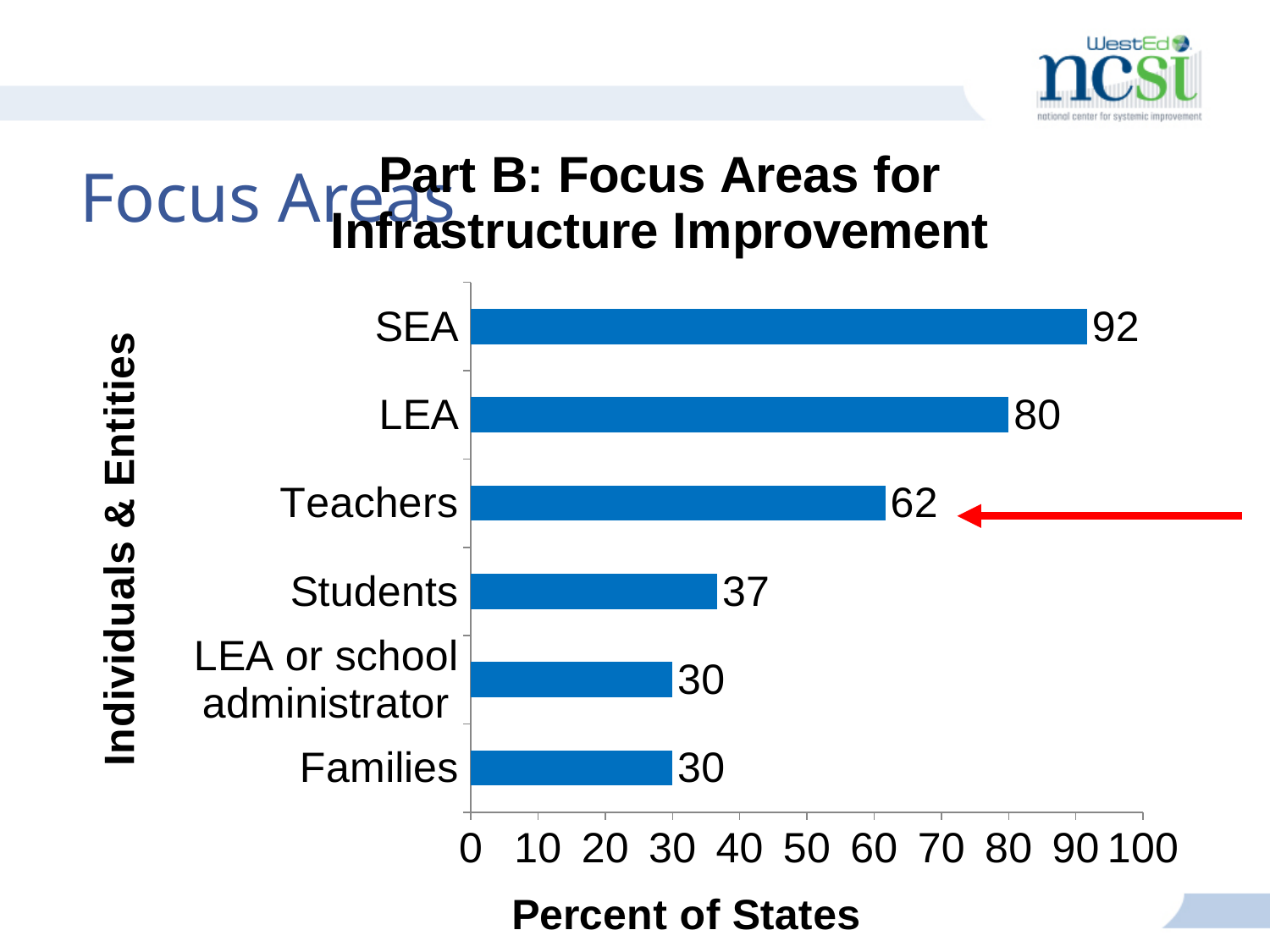
Which category has the highest value? SEA What is the label of the horizontal axis? Percent of States How many categories are shown in the chart? 6 What is the difference between the values for SEA and LEA? 12 What kind of chart is shown on the slide? bar chart What is the value for SEA? 92 Which is larger, the value for LEA or the value for Teachers? LEA What is the value for Students? 37 Is the value for Students greater or less than 40? less What is the value for LEA or school administrator? 30 What is the difference between the values for Teachers and Students? 25 What is the value for Teachers? 62